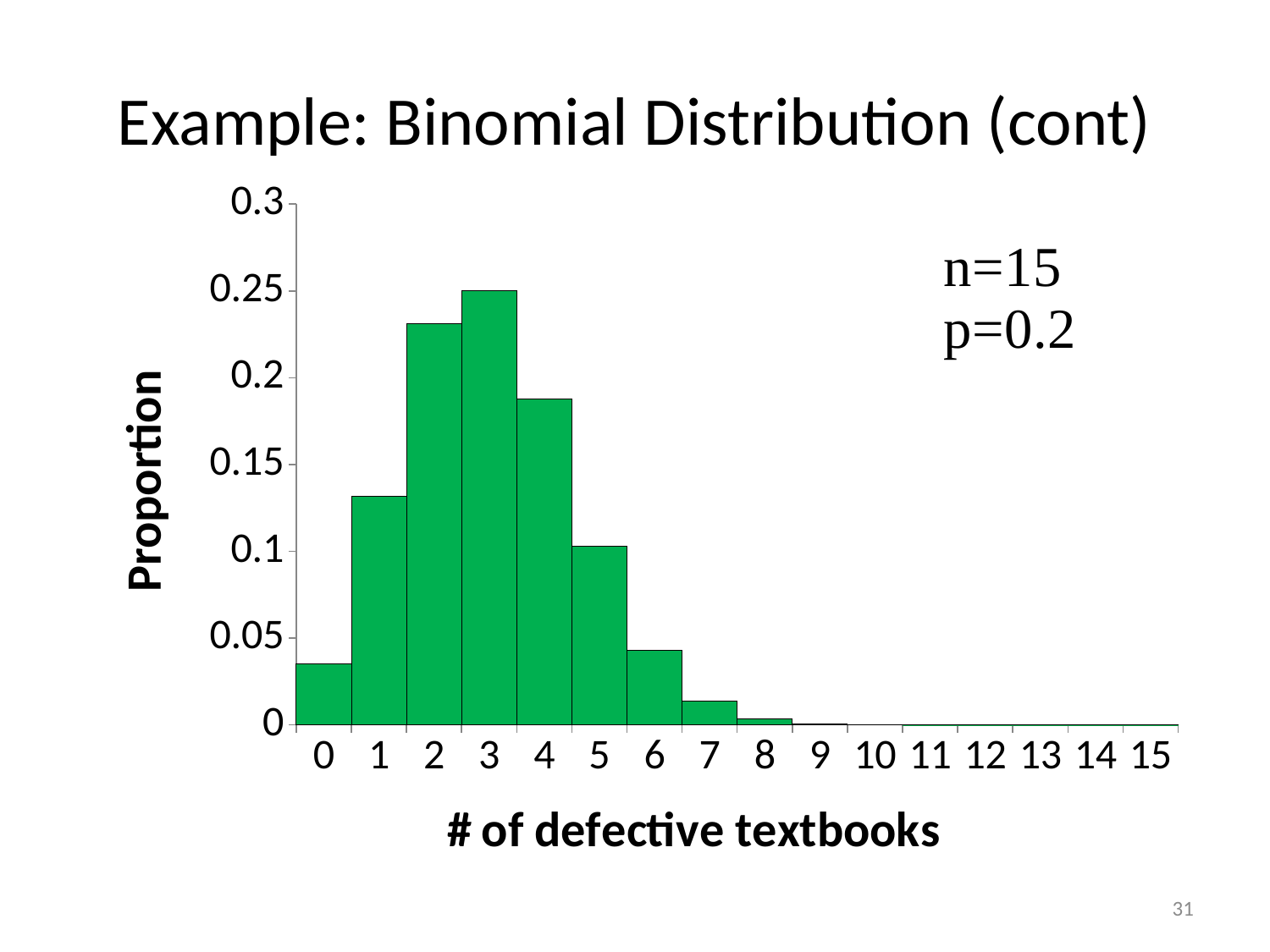
What is the label of the x axis? # of defective textbooks Is the proportion for 6 defective textbooks greater or less than 0.05? less Which has a larger proportion: 1 defective textbook or 5 defective textbooks? 1 What values of n and p are annotated on the chart? n=15, p=0.2 Is the proportion for 1 defective textbook greater or less than 0.15? less Is the proportion for 0 defective textbooks greater or less than 0.05? less How many categories are shown on the x axis? 16 Which number of defective textbooks has the highest proportion? 3 What kind of chart is shown on the slide? bar chart Which has a larger proportion: 2 defective textbooks or 4 defective textbooks? 2